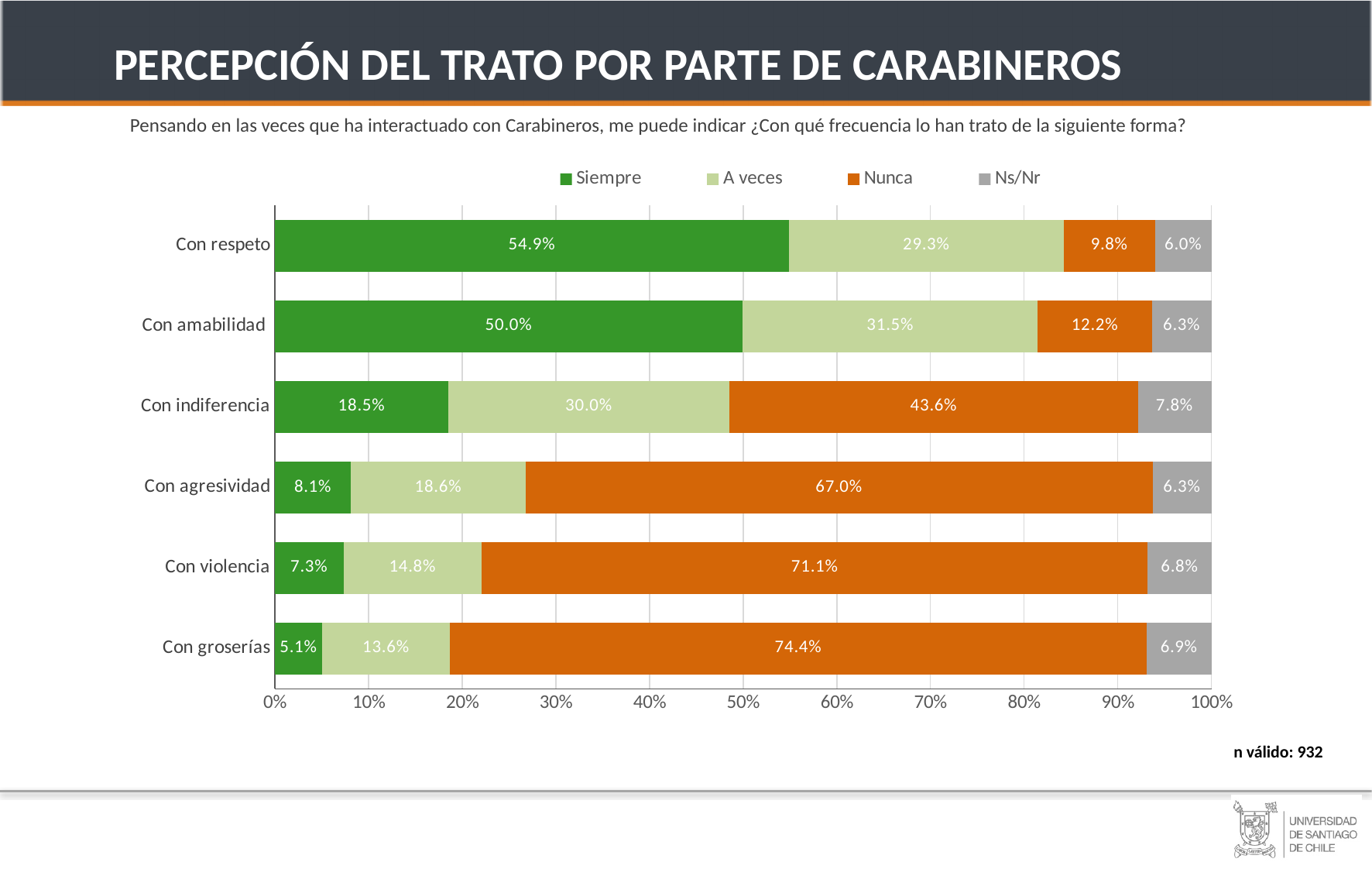
Which category has the highest 'Siempre' value? Con respeto What kind of chart is shown on the slide? Stacked bar chart What is the 'Ns/Nr' value for 'Con violencia'? 6.8% What is the 'Siempre' value for 'Con respeto'? 54.9% What is the valid sample size (n válido) shown on the slide? 932 How many categories are shown on the y axis? 6 What is the difference between the 'Nunca' values for 'Con violencia' and 'Con agresividad'? 4.1% What is the 'Nunca' value for 'Con groserías'? 74.4% Which category has the lowest 'Nunca' value? Con respeto Which is larger: the 'A veces' value for 'Con amabilidad' or for 'Con respeto'? Con amabilidad What is the 'A veces' value for 'Con indiferencia'? 30.0% How many series does the legend list? 4